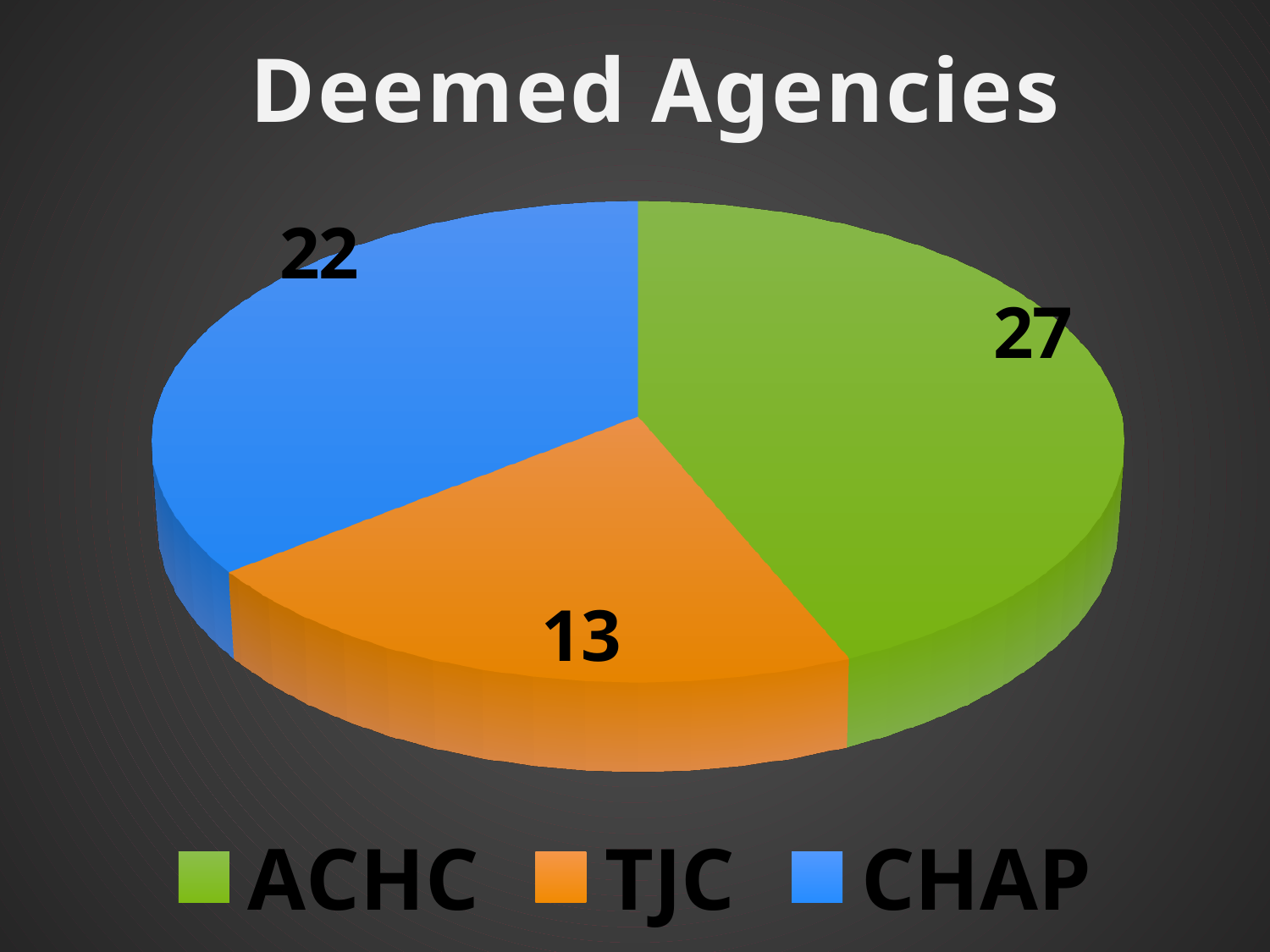
What is the difference between the values for ACHC and CHAP? 5 Which agency has the smallest slice of the pie? TJC What is the value for CHAP? 22 What kind of chart is shown on the slide? Pie chart How many slices does the pie chart have? 3 What is the difference between the values for ACHC and TJC? 14 What is the total of all the slices in the pie chart? 62 What is the value for ACHC? 27 Which is larger, the value for CHAP or the value for TJC? CHAP What is the title of the chart? Deemed Agencies What is the value for TJC? 13 Which agency has the largest slice of the pie? ACHC